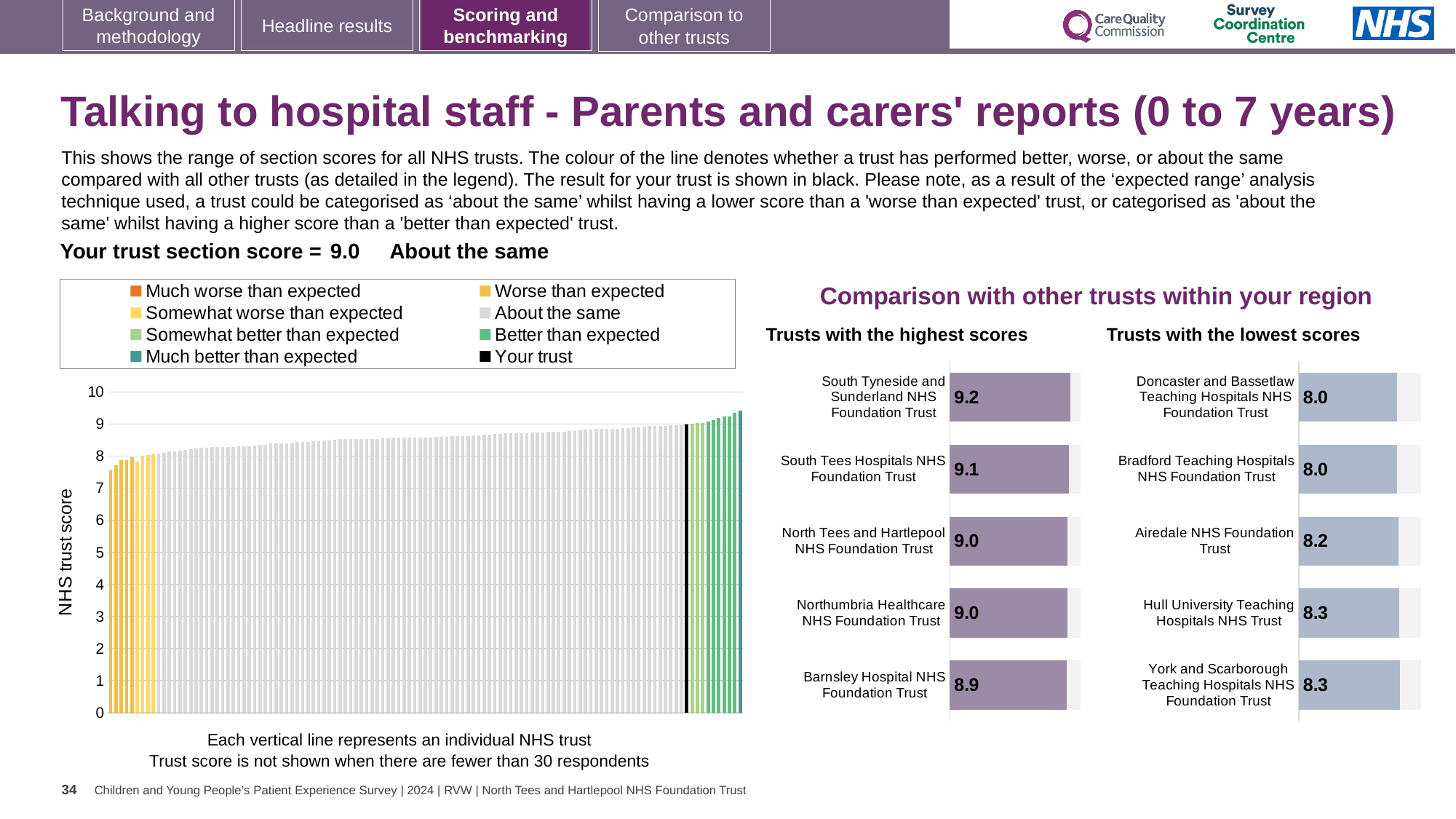
In the 'Trusts with the highest scores' chart, which trust has the lowest score? Barnsley Hospital NHS Foundation Trust In the 'Trusts with the lowest scores' chart, which has the higher score: Airedale NHS Foundation Trust or Bradford Teaching Hospitals NHS Foundation Trust? Airedale NHS Foundation Trust How many entries does the legend of the main NHS trust score chart list? 8 In the 'Trusts with the highest scores' chart, what is the difference between the scores of South Tyneside and Sunderland NHS Foundation Trust and Barnsley Hospital NHS Foundation Trust? 0.3 In the 'Trusts with the lowest scores' chart, what is the score for Airedale NHS Foundation Trust? 8.2 What kind of chart is the main NHS trust score chart on the left? Bar chart In the 'Trusts with the highest scores' chart, what is the score for South Tyneside and Sunderland NHS Foundation Trust? 9.2 In the main NHS trust score chart on the left, is the value of the leftmost (lowest) bar greater or less than 8? less In the main NHS trust score chart on the left, do the values rise or fall from left to right? Rise In the 'Trusts with the highest scores' chart, which trust has the highest score? South Tyneside and Sunderland NHS Foundation Trust How many trusts are shown in the 'Trusts with the lowest scores' chart? 5 In the 'Trusts with the lowest scores' chart, what is the difference between the scores of Hull University Teaching Hospitals NHS Trust and Doncaster and Bassetlaw Teaching Hospitals NHS Foundation Trust? 0.3